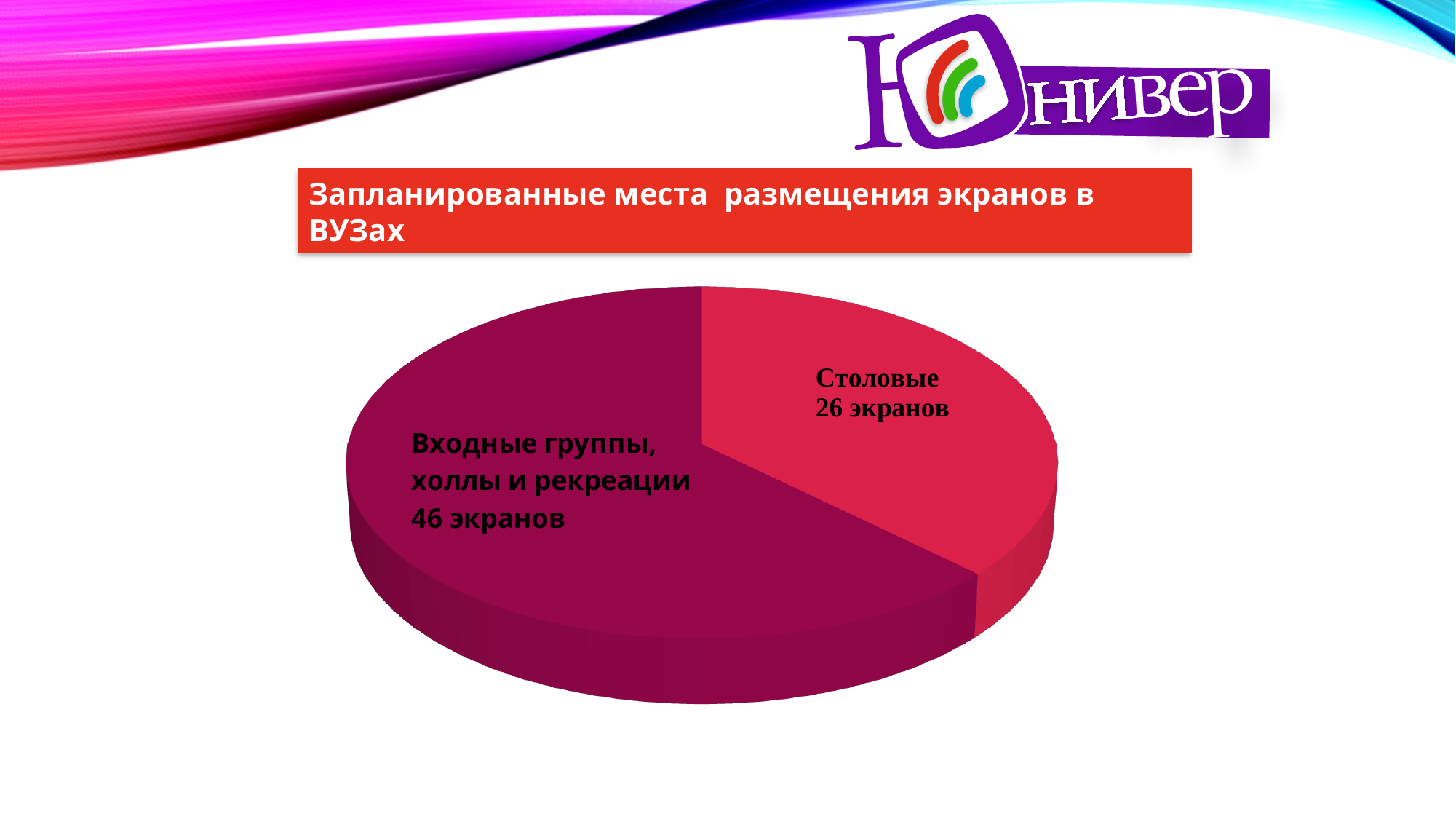
Which is larger: the number of screens for Столовые or for Входные группы, холлы и рекреации? Входные группы, холлы и рекреации How many screens are planned for Входные группы, холлы и рекреации? 46 экранов Which category has the larger number of screens in the pie chart? Входные группы, холлы и рекреации What is the title of the chart on the slide? Запланированные места размещения экранов в ВУЗах What is the total number of screens across both slices of the pie chart? 72 What type of chart is shown on the slide? Pie chart How many slices does the pie chart have? 2 What is the difference in the number of screens between Входные группы, холлы и рекреации and Столовые? 20 Which slice of the pie chart is shown in the darker colour? Входные группы, холлы и рекреации How many screens are planned for Столовые according to the pie chart? 26 экранов Which category has the smaller number of screens in the pie chart? Столовые